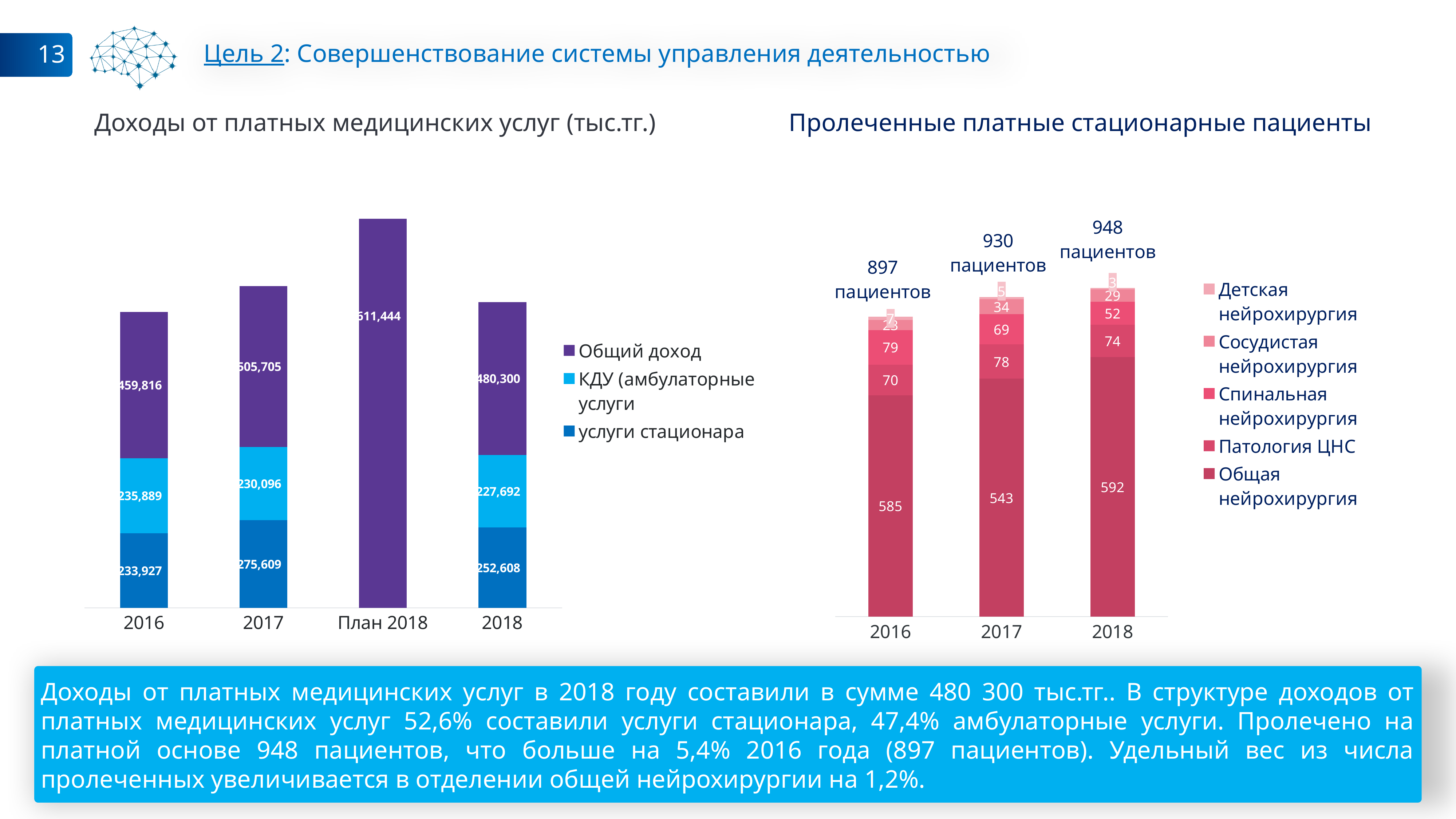
On the chart 'Пролеченные платные стационарные пациенты', which year has the lowest value for 'Общая нейрохирургия'? 2017 On the chart 'Доходы от платных медицинских услуг (тыс.тг.)', what is the value of 'Общий доход' for 2018? 480,300 On the chart 'Пролеченные платные стационарные пациенты', what is the value of 'Общая нейрохирургия' for 2018? 592 On the chart 'Пролеченные платные стационарные пациенты', what is the total number of patients labelled for 2017? 930 пациентов On the chart 'Доходы от платных медицинских услуг (тыс.тг.)', what is the difference between 'услуги стационара' in 2017 and in 2016? 41,682 On the chart 'Доходы от платных медицинских услуг (тыс.тг.)', which category has the highest 'Общий доход'? План 2018 On the chart 'Доходы от платных медицинских услуг (тыс.тг.)', how many series does the legend list? 3 On the chart 'Доходы от платных медицинских услуг (тыс.тг.)', what is the value of 'КДУ (амбулаторные услуги' for 2016? 235,889 On the chart 'Доходы от платных медицинских услуг (тыс.тг.)', how many categories are shown on the x axis? 4 What type of chart is 'Пролеченные платные стационарные пациенты'? Stacked bar chart On the chart 'Пролеченные платные стационарные пациенты', is the value of 'Спинальная нейрохирургия' larger in 2016 or in 2018? 2016 On the chart 'Доходы от платных медицинских услуг (тыс.тг.)', what is the value of 'услуги стационара' for 2017? 275,609